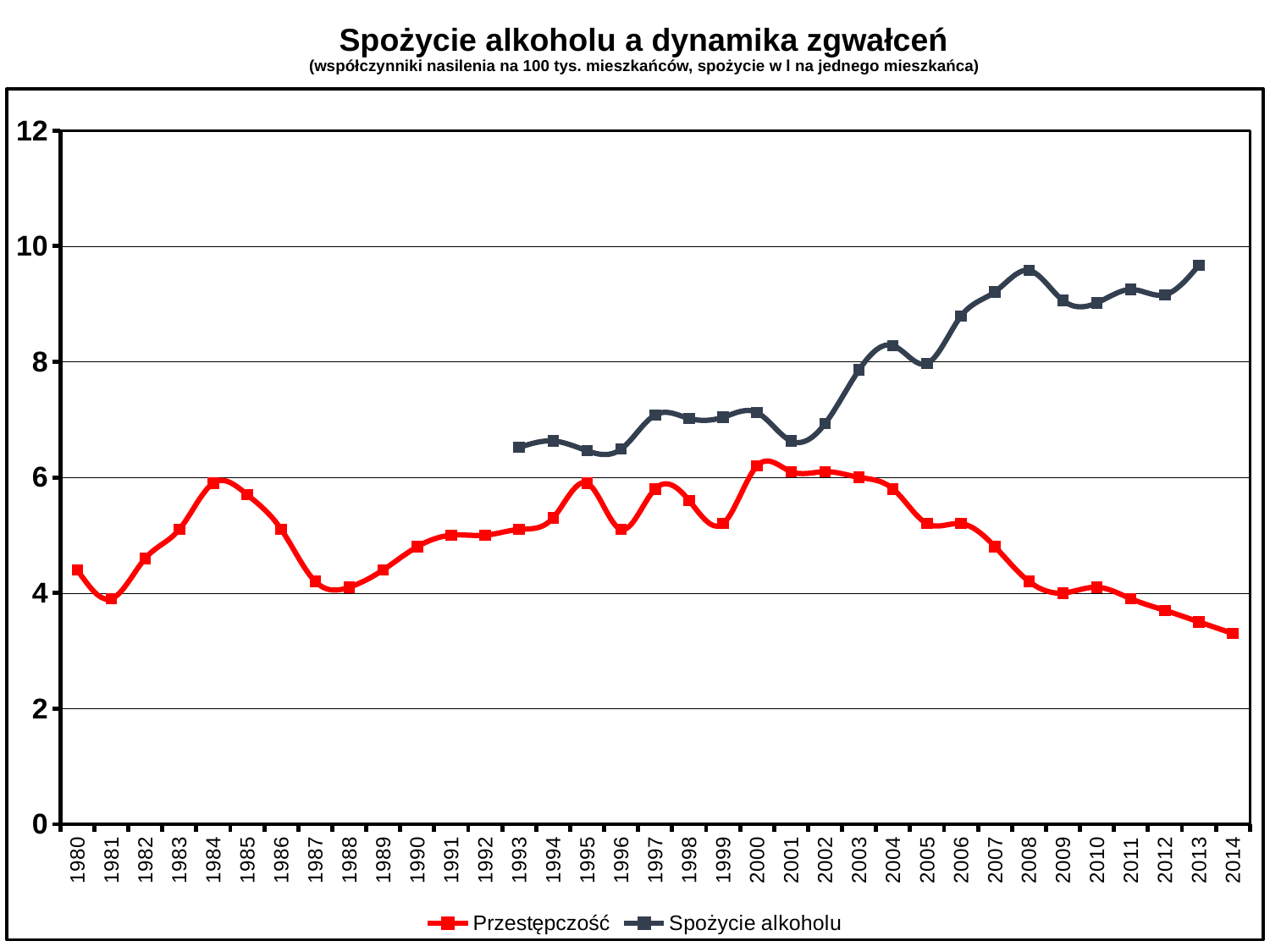
Which year has the lowest value for Przestępczość? 2014 What kind of chart is shown on the slide? line chart How many years are shown on the x axis? 35 In 2013, which series has the larger value, Przestępczość or Spożycie alkoholu? Spożycie alkoholu Is the value for Przestępczość in 2014 greater or less than 4? less Is the value for Spożycie alkoholu in 2006 greater or less than 8? greater Is the value for Spożycie alkoholu in 2013 greater or less than 10? less What colour is the Przestępczość line? red Does the Przestępczość series rise or fall from 2002 to 2014? fall For Przestępczość, which year has the larger value, 1984 or 1987? 1984 How many series does the legend list? 2